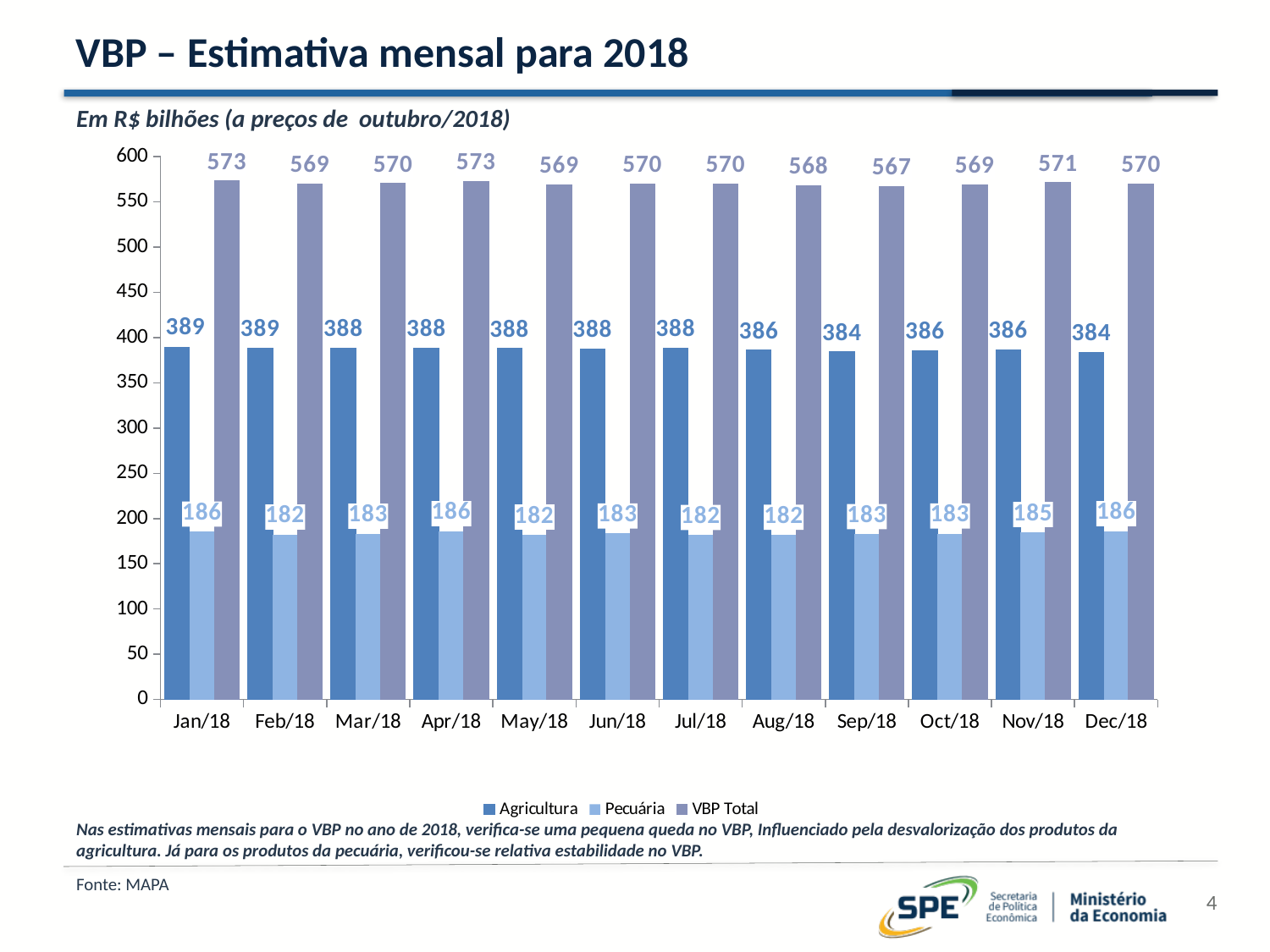
What is the value for Pecuária in Nov/18? 185 What is the difference between the VBP Total values for Apr/18 and Aug/18? 5 How many months are shown on the x axis? 12 What kind of chart is shown on the slide? bar chart How many series does the legend list? 3 What is the value for Agricultura in Jan/18? 389 In which month is the VBP Total lowest? Sep/18 Is the Agricultura value for Jul/18 greater or less than 400? less What is the difference between the Agricultura values for Jan/18 and Dec/18? 5 Do the Agricultura values rise or fall from Jan/18 to Dec/18? fall What is the VBP Total value for Sep/18? 567 Which month has the larger Pecuária value, Jan/18 or Feb/18? Jan/18